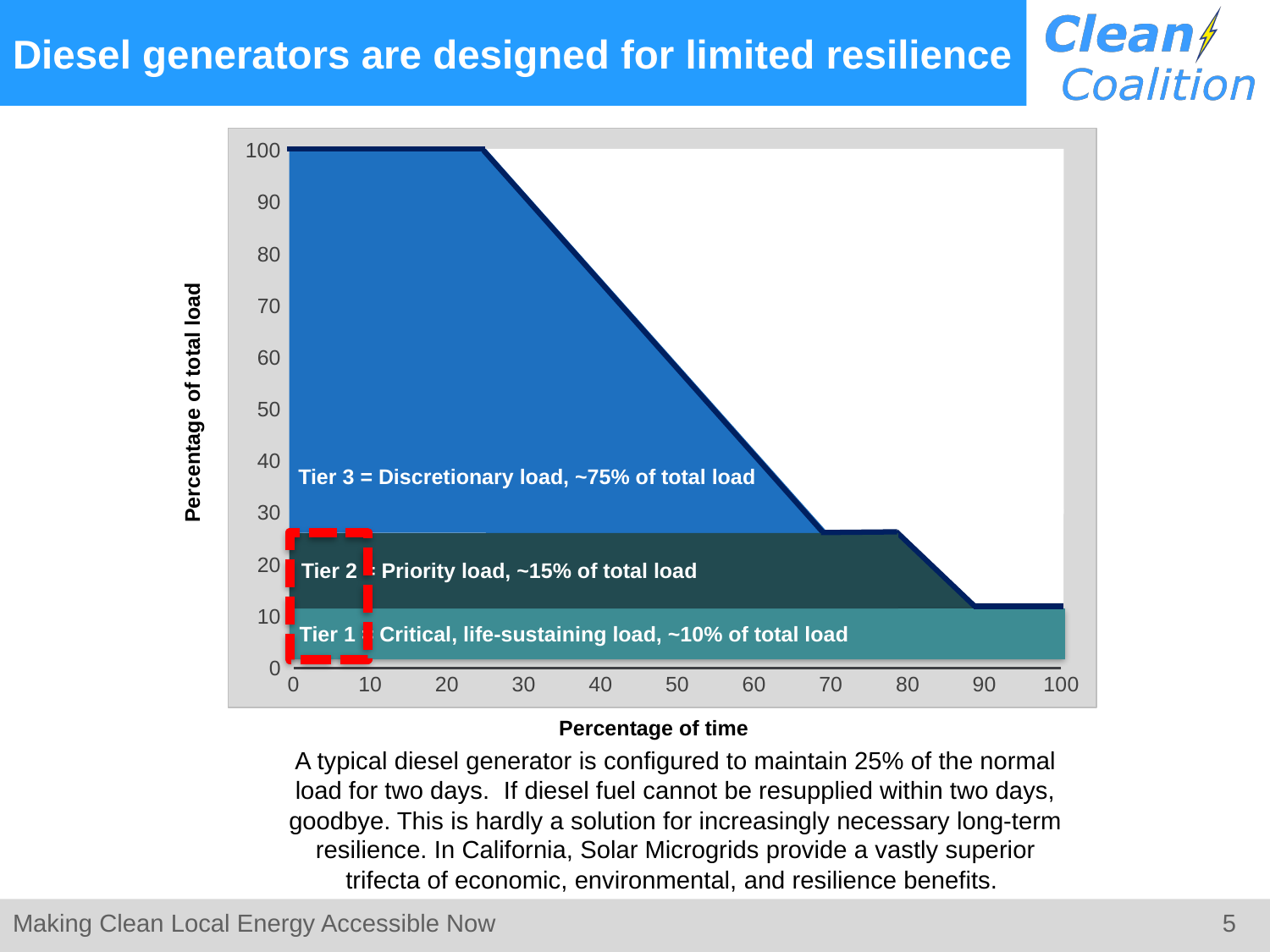
Is the percentage of total load at 10 percent of time greater or less than 90? greater Is the percentage of total load at 75 percent of time greater or less than 40? less Is the percentage of total load at 60 percent of time greater or less than 50? less What is the percentage of total load at 0 percent of time? 100 Which is larger, the percentage of total load at 30 percent of time or at 80 percent of time? 30 percent of time What is the title of the x axis? Percentage of time What kind of chart is shown on the slide? area chart Overall, does the percentage of total load rise or fall as the percentage of time increases? fall What is the percentage of total load at 20 percent of time? 100 What is the title of the y axis? Percentage of total load